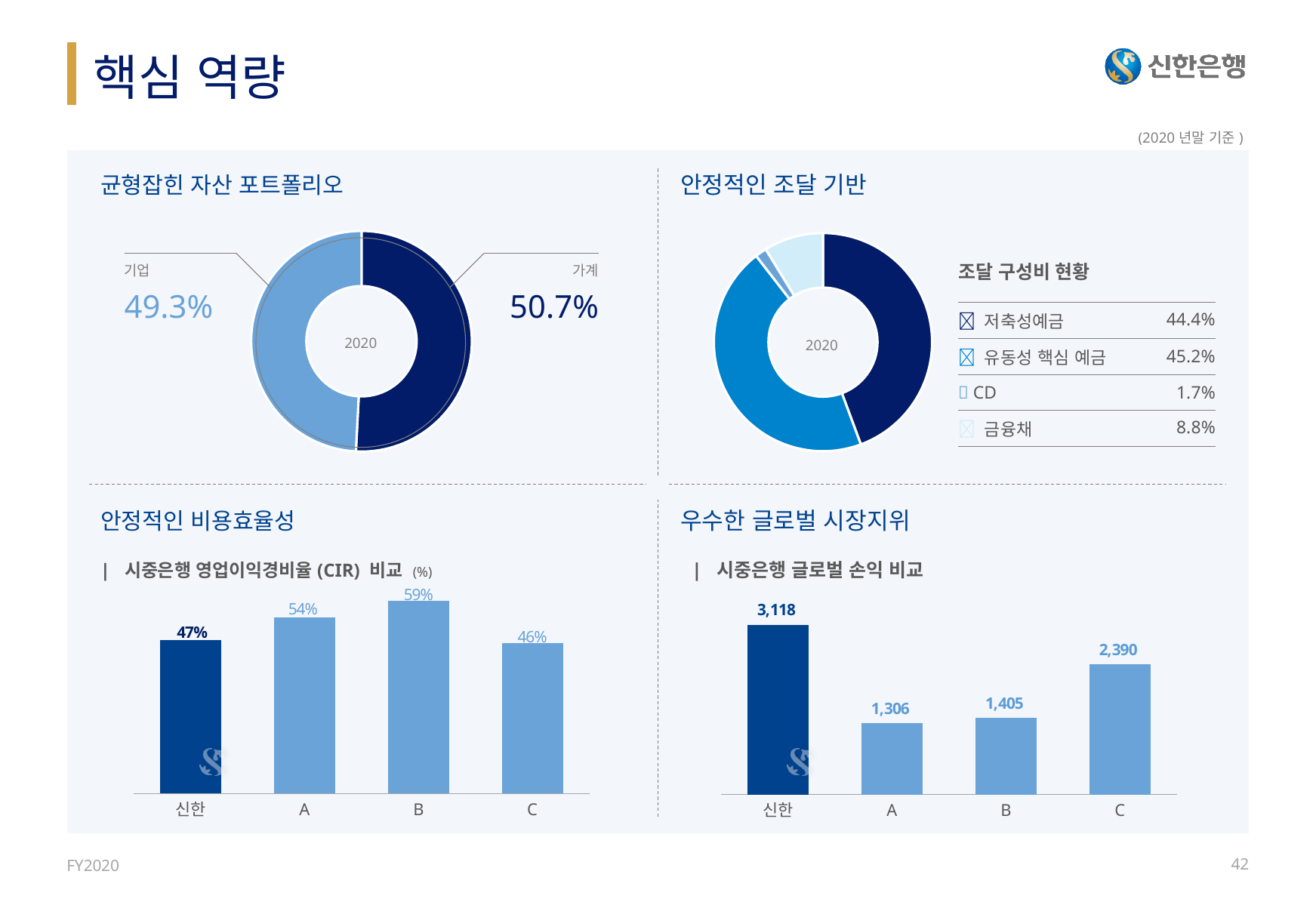
In the '시중은행 글로벌 손익 비교' chart, which bank has the lowest value? A In the '시중은행 영업이익경비율 (CIR) 비교' chart, which bank has the highest CIR? B In the '안정적인 조달 기반' donut chart, how many categories are listed in the legend? 4 In the '안정적인 조달 기반' donut chart, which category has the smallest share? CD In the '시중은행 영업이익경비율 (CIR) 비교' chart, what is the difference between B and C? 13% In the '시중은행 글로벌 손익 비교' chart, what is the value for 신한? 3,118 In the '시중은행 영업이익경비율 (CIR) 비교' chart, what is the value for 신한? 47% In the '균형잡힌 자산 포트폴리오' donut chart, what share is labelled for 가계? 50.7% In the '안정적인 조달 기반' donut chart, what is the difference between the shares of 금융채 and CD? 7.1% In the '안정적인 조달 기반' donut chart, what is the share for 유동성 핵심 예금? 45.2% What type of chart is the '시중은행 글로벌 손익 비교' chart? Bar chart In the '균형잡힌 자산 포트폴리오' donut chart, what share is labelled for 기업? 49.3%